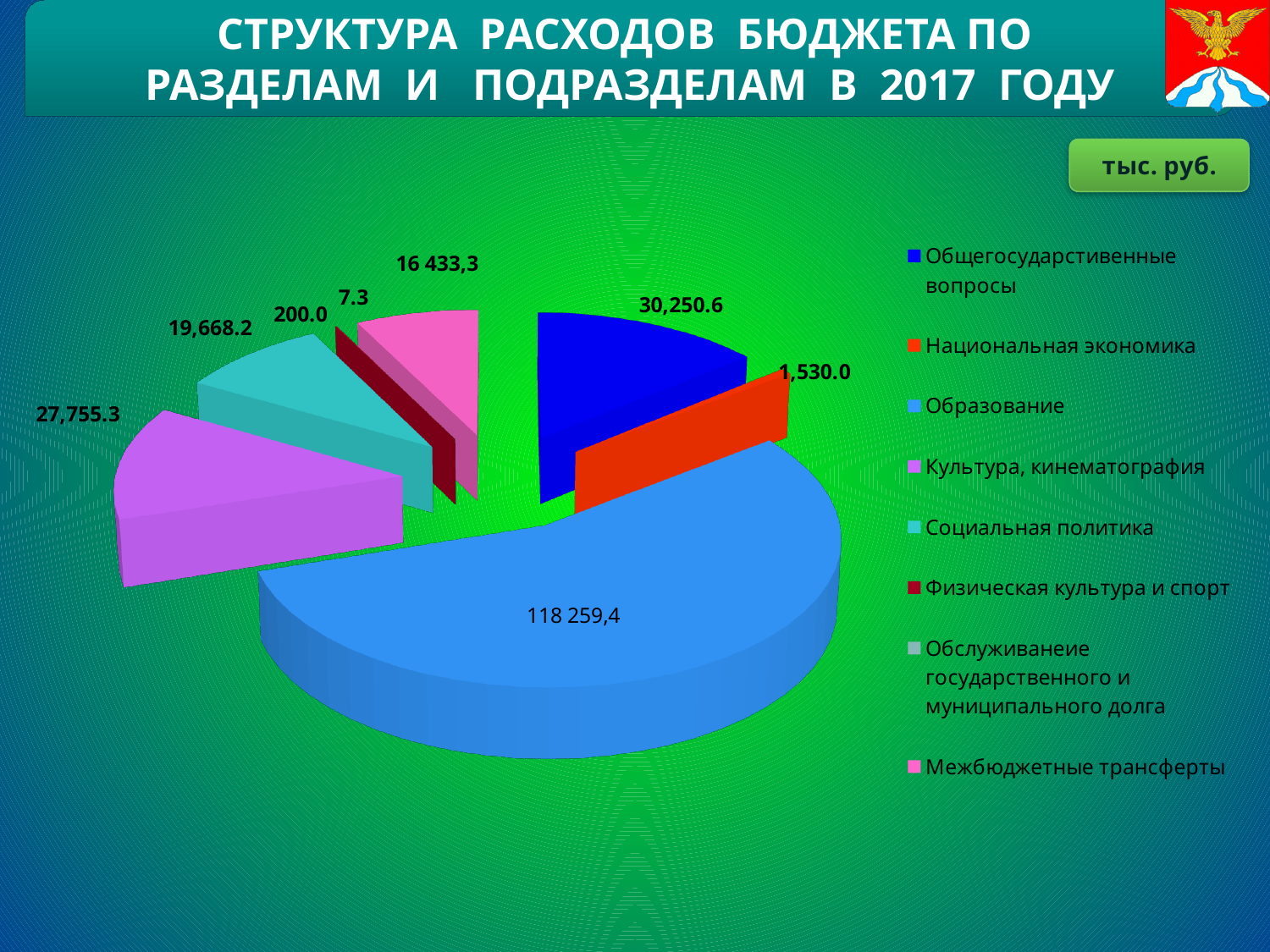
What value is shown for Национальная экономика? 1,530.0 What value is shown for Культура, кинематография? 27,755.3 What kind of chart is shown on the slide? Pie chart Which category has the smallest value on the chart? Обслуживание государственного и муниципального долга What is the difference between the values for Общегосударственные вопросы and Культура, кинематография? 2,495.3 How many categories does the legend list? 8 What value is shown for Социальная политика? 19,668.2 What value is shown for Общегосударственные вопросы? 30,250.6 Which category has the largest slice of the pie? Образование What value is shown for Межбюджетные трансферты? 16 433,3 What value is shown for Образование on the pie chart? 118 259,4 Which is larger: Социальная политика or Межбюджетные трансферты? Социальная политика